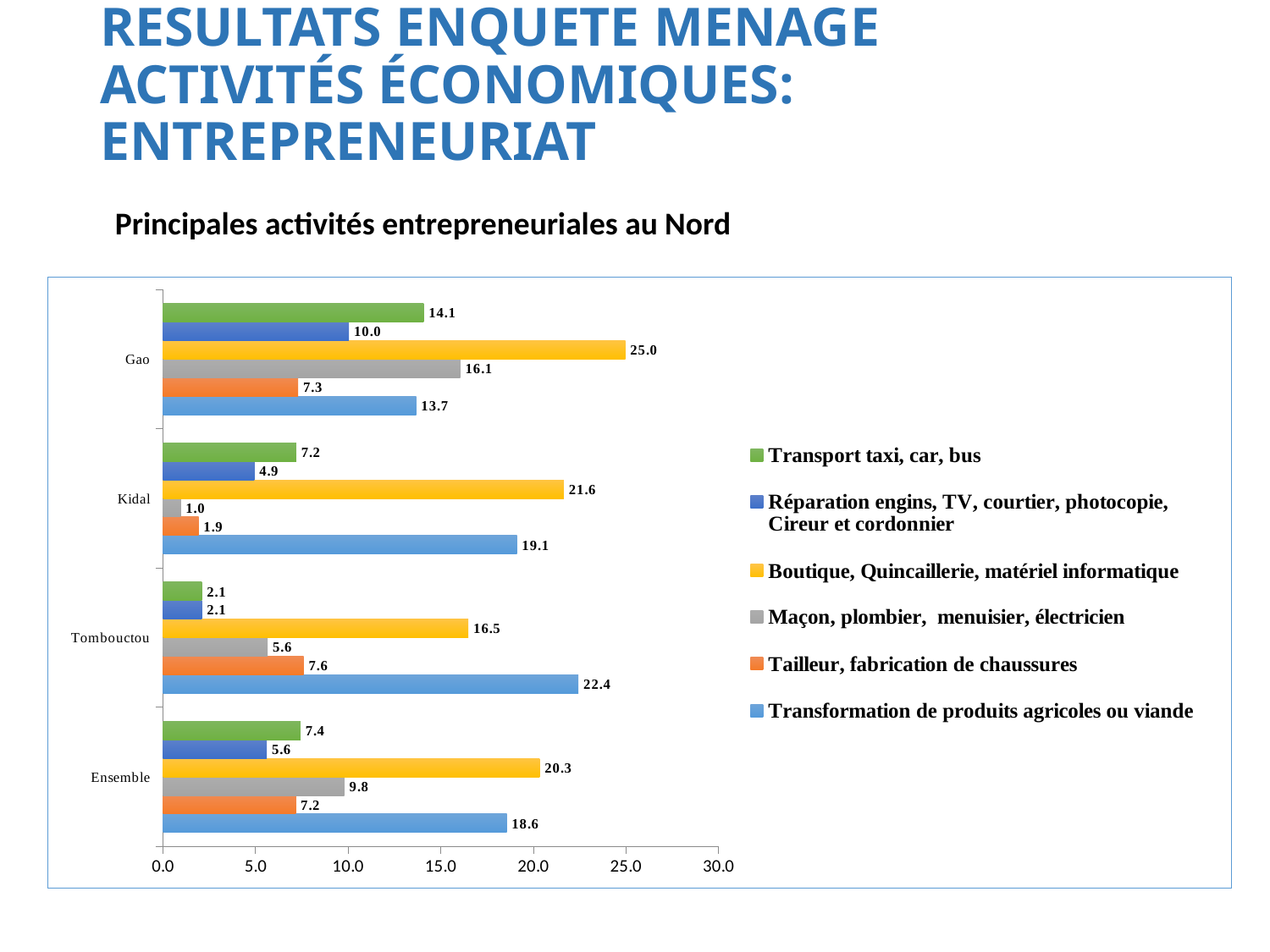
What kind of chart is shown on the slide? Bar chart What is the title of the chart? Principales activités entrepreneuriales au Nord Is the value for Réparation engins, TV, courtier, photocopie, Cireur et cordonnier in Gao greater or less than 15.0? less What is the value for Transformation de produits agricoles ou viande in Tombouctou? 22.4 How many series does the legend list? 6 Which is larger in Kidal: Transformation de produits agricoles ou viande or Transport taxi, car, bus? Transformation de produits agricoles ou viande What is the value for Maçon, plombier, menuisier, électricien in Kidal? 1.0 Which region has the lowest value for Transport taxi, car, bus? Tombouctou How many regions (categories) are shown on the chart? 4 What is the difference between the Boutique, Quincaillerie, matériel informatique value and the Transformation de produits agricoles ou viande value for Ensemble? 1.7 Which region has the highest value for Boutique, Quincaillerie, matériel informatique? Gao What is the value for Boutique, Quincaillerie, matériel informatique in Gao? 25.0